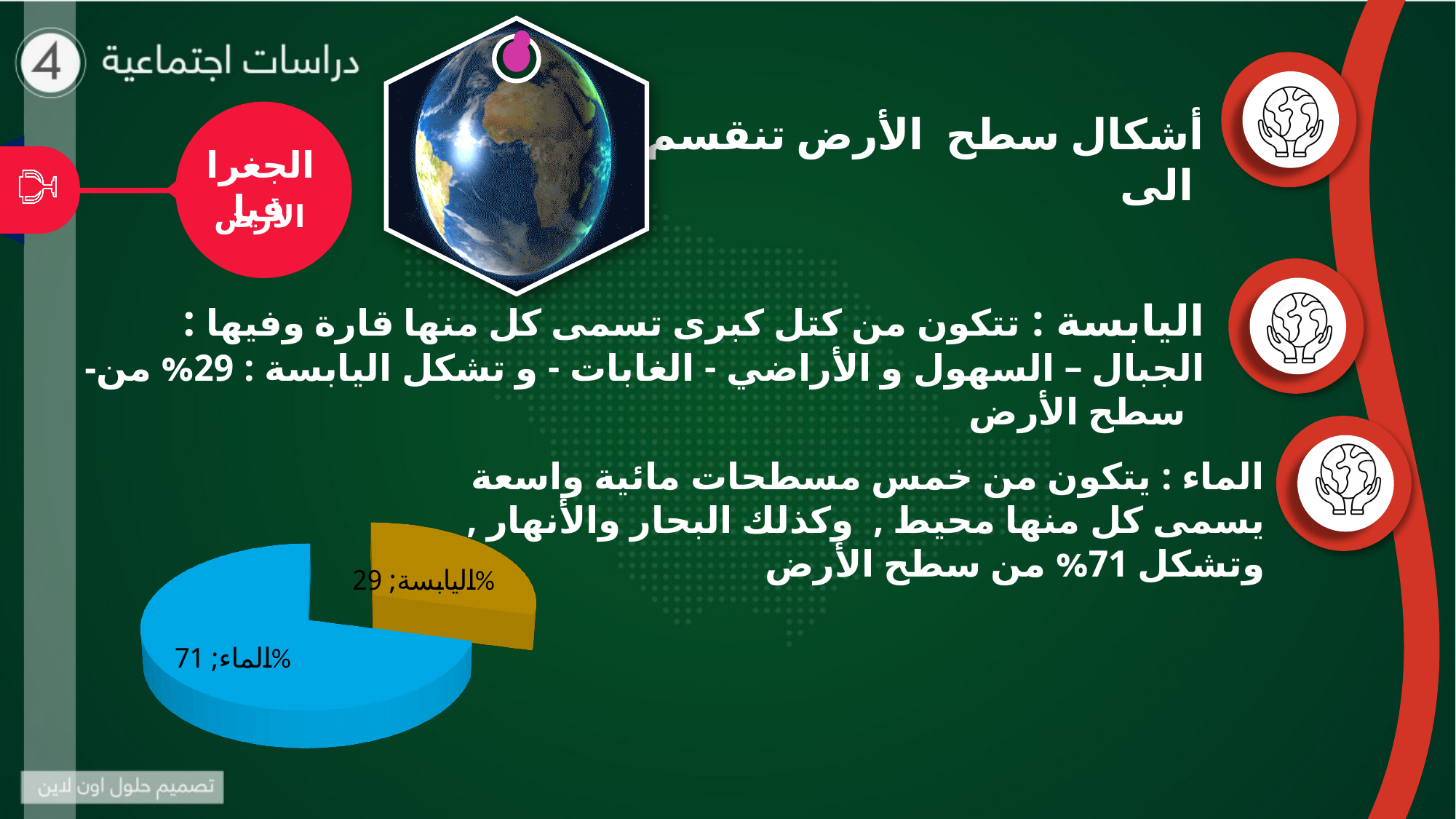
Which slice of the pie chart is the smallest? اليابسة What is the value shown for الماء in the pie chart? 71% What colour is the الماء slice in the pie chart? blue Which slice of the pie chart is the largest? الماء What is the value shown for اليابسة in the pie chart? 29% How many slices does the pie chart have? 2 What share of the pie does the الماء slice represent? 71% What colour is the اليابسة slice in the pie chart? yellow What kind of chart is shown on the slide? pie chart What is the difference between the values for الماء and اليابسة in the pie chart? 42% Which is larger in the pie chart, الماء or اليابسة? الماء